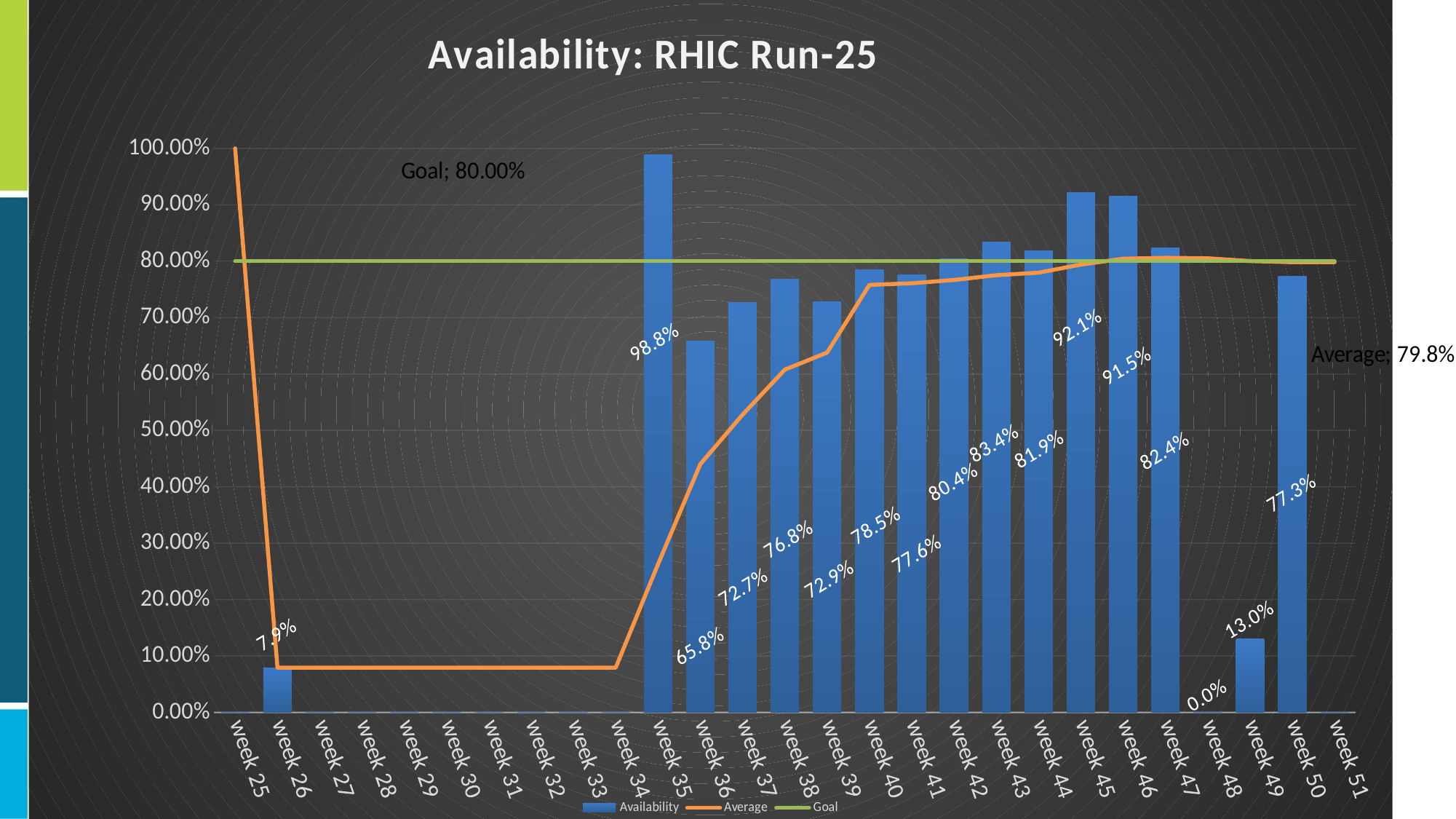
What is the availability for week 49? 13.0% Which week has the highest availability? week 35 Which has higher availability, week 38 or week 39? week 38 What is the difference in availability between week 35 and week 36? 33.0% What is the availability for week 35? 98.8% What is the availability for week 26? 7.9% How many series does the legend list? 3 What value is shown for the Average at the end of the chart? 79.8% What is the difference in availability between week 43 and week 42? 3.0% What value is shown for the Goal line? 80.00% Is the availability for week 36 greater or less than 70.00%? less What is the availability for week 45? 92.1%